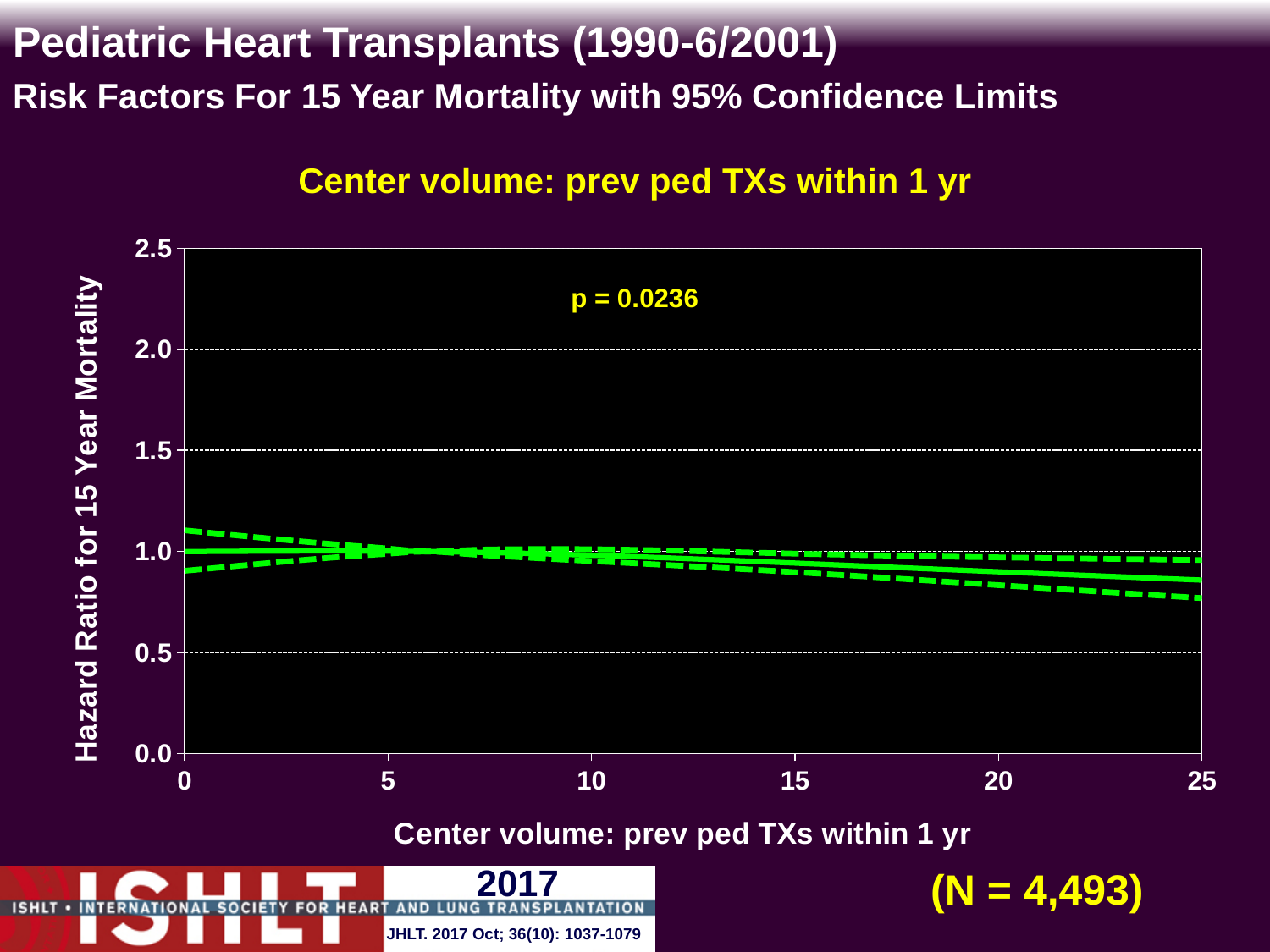
Is the upper 95% confidence limit at a center volume of 0 greater or less than 1.0? greater Is the hazard ratio at a center volume of 25 greater or less than 1.0? less Does the hazard ratio line rise or fall as center volume increases from 0 to 25? fall Is the hazard ratio at a center volume of 25 greater or less than 1.5? less What is the sample size (N) shown on the slide? N = 4,493 What is the p-value printed on the chart? p = 0.0236 Is the hazard ratio at a center volume of 0 larger or smaller than the hazard ratio at a center volume of 25? larger What is the highest value shown on the y axis? 2.5 What kind of chart is shown on the slide? line chart